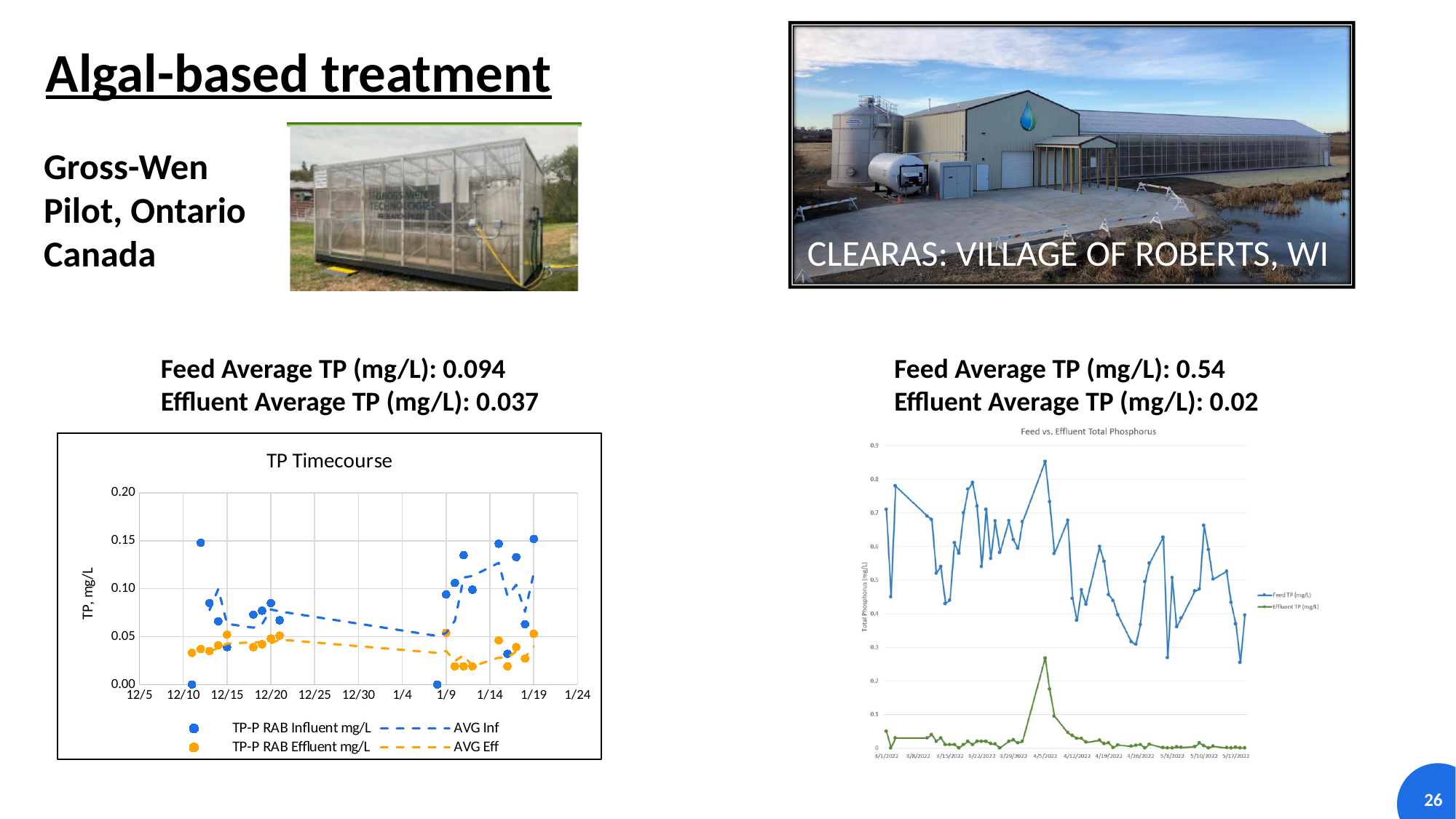
In the TP Timecourse chart, are all the TP-P RAB Effluent mg/L points greater or less than 0.10? less In the TP Timecourse chart, which series reaches the highest plotted value, TP-P RAB Influent mg/L or TP-P RAB Effluent mg/L? TP-P RAB Influent mg/L In the Feed vs. Effluent Total Phosphorus chart, is the peak Effluent TP (mg/L) value greater or less than 0.2? greater In the Feed vs. Effluent Total Phosphorus chart, is the highest Feed TP (mg/L) value greater or less than 0.8? greater How many entries does the legend of the TP Timecourse chart list? 4 What kind of chart is the Feed vs. Effluent Total Phosphorus chart on the right? line chart How many series does the legend of the Feed vs. Effluent Total Phosphorus chart list? 2 What kind of chart is the TP Timecourse chart on the left? scatter chart In the Feed vs. Effluent Total Phosphorus chart, which series reaches the highest value? Feed TP (mg/L) What is the y-axis label of the TP Timecourse chart? TP, mg/L What is the title of the chart on the left of the slide? TP Timecourse